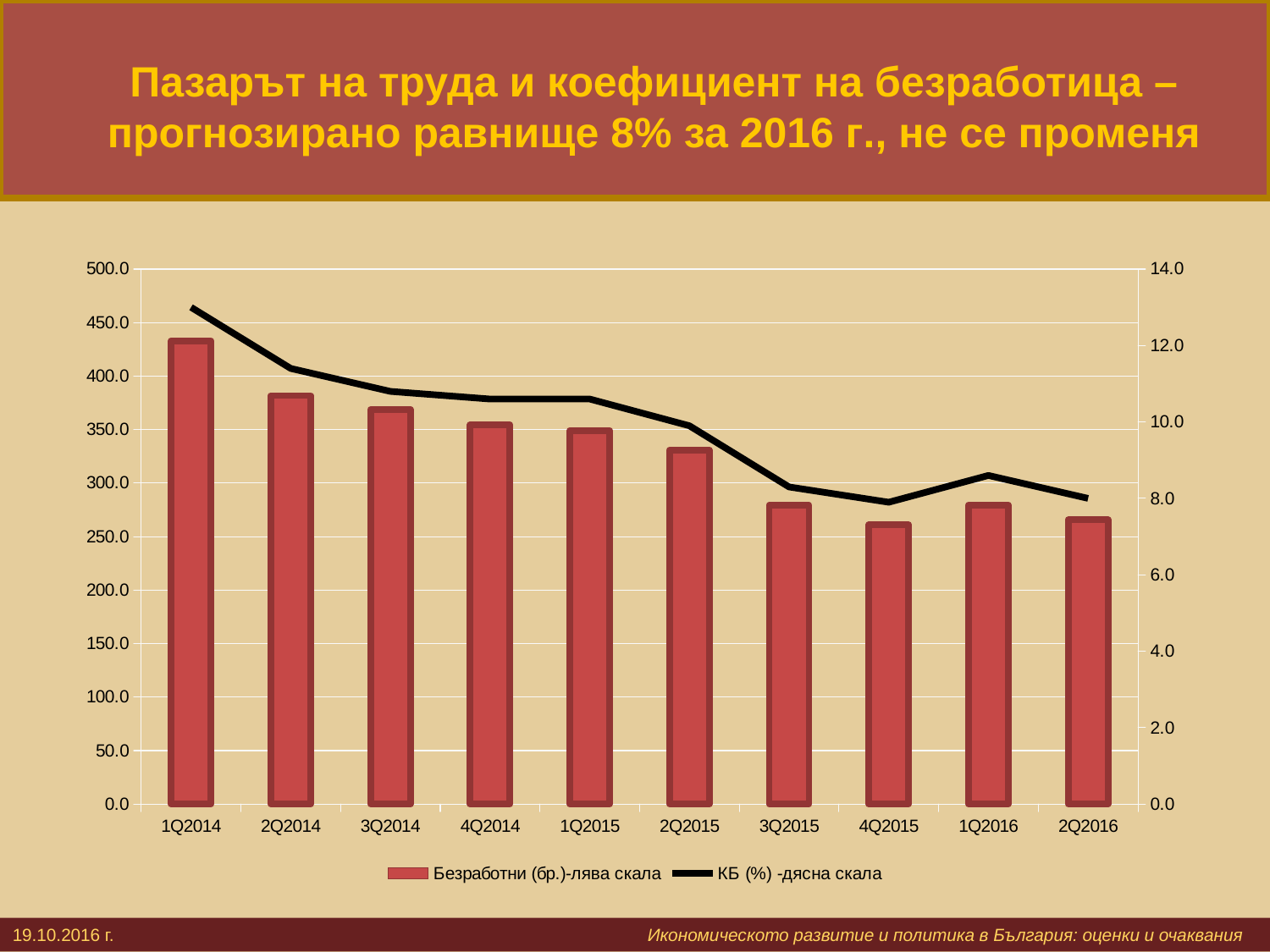
What kind of chart is shown on the slide? A combined bar and line chart Is the bar value for Безработни (бр.) in 4Q2015 greater or less than 250? greater Is the КБ (%) line value in 1Q2014 greater or less than 12.0 on the right axis? greater Do the Безработни (бр.) bars generally rise or fall from 1Q2014 to 2Q2016? Fall How many quarters are shown on the x axis of the chart? 10 Which has the larger bar for Безработни (бр.): 2Q2015 or 3Q2015? 2Q2015 Is the bar value for Безработни (бр.) in 1Q2014 greater or less than 400? greater How many series does the chart legend list? 2 Which series in the legend is plotted against the right-hand scale? КБ (%) -дясна скала Which quarter has the highest bar for Безработни (бр.)? 1Q2014